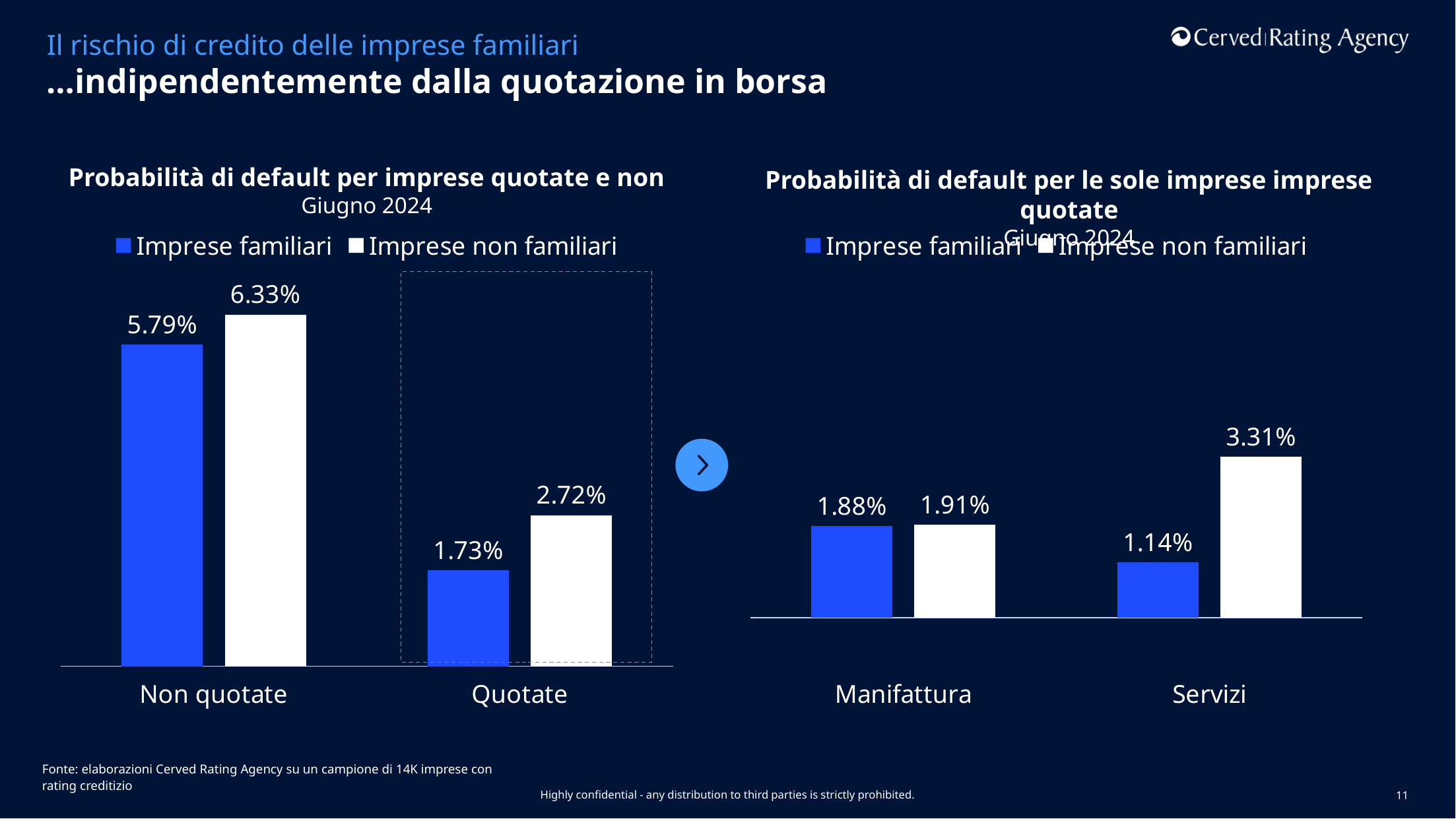
In the left chart (Probabilità di default per imprese quotate e non), which is larger for Quotate: Imprese familiari or Imprese non familiari? Imprese non familiari What kind of chart is the left chart (Probabilità di default per imprese quotate e non)? Bar chart In the left chart (Probabilità di default per imprese quotate e non), what is the difference between Imprese non familiari and Imprese familiari in the Non quotate category? 0.54 percentage points In the right chart (Probabilità di default per le sole imprese quotate), what is the difference between Imprese non familiari and Imprese familiari in Servizi? 2.17 percentage points In the left chart (Probabilità di default per imprese quotate e non), what is the value for Imprese familiari in the Non quotate category? 5.79% In the left chart (Probabilità di default per imprese quotate e non), which bar is the highest? Imprese non familiari, Non quotate (6.33%) In the right chart (Probabilità di default per le sole imprese quotate), which bar is the lowest? Imprese familiari, Servizi (1.14%) In the right chart (Probabilità di default per le sole imprese quotate), how many series does the legend list? 2 In the left chart (Probabilità di default per imprese quotate e non), how many categories are shown on the x axis? 2 In the right chart (Probabilità di default per le sole imprese quotate), what is the value for Imprese familiari in Manifattura? 1.88% In the left chart (Probabilità di default per imprese quotate e non), what is the value for Imprese non familiari in the Quotate category? 2.72% In the right chart (Probabilità di default per le sole imprese quotate), what is the value for Imprese non familiari in Servizi? 3.31%